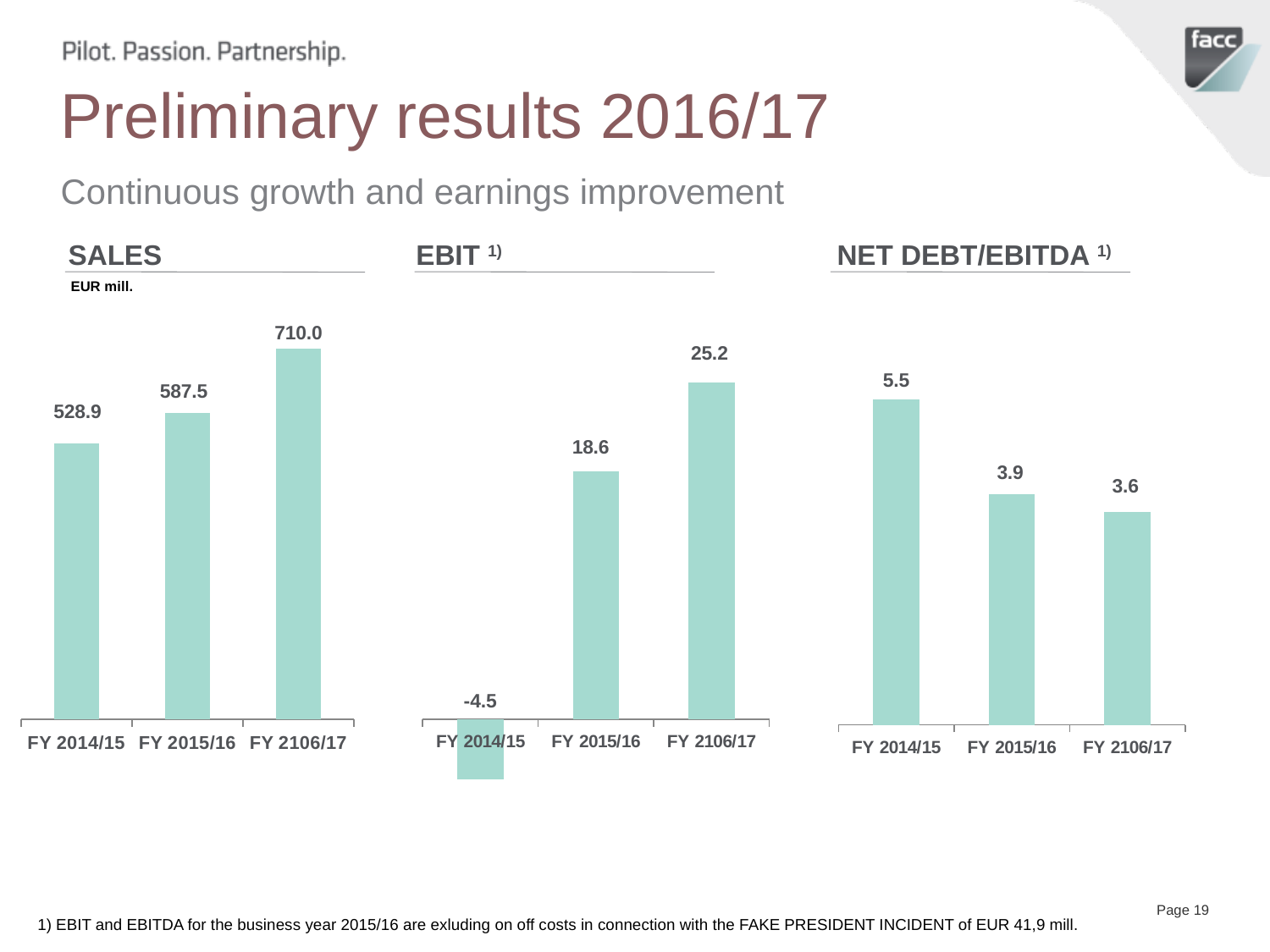
In the SALES chart, what is the value for FY 2015/16? 587.5 In the EBIT chart, which fiscal year has the lowest value? FY 2014/15 In the EBIT chart, what is the value for FY 2014/15? -4.5 In the SALES chart, how many fiscal years are shown? 3 What unit is stated under the SALES chart title? EUR mill. In the NET DEBT/EBITDA chart, what is the value for FY 2014/15? 5.5 What type of chart is the EBIT chart? bar chart In the EBIT chart, what is the difference between the FY 2106/17 value and the FY 2015/16 value? 6.6 In the SALES chart, which fiscal year has the highest value? FY 2106/17 In the SALES chart, what is the difference between the FY 2106/17 value and the FY 2014/15 value? 181.1 In the NET DEBT/EBITDA chart, which fiscal year has the lowest value? FY 2106/17 In the NET DEBT/EBITDA chart, do the values rise or fall from FY 2014/15 to FY 2106/17? fall